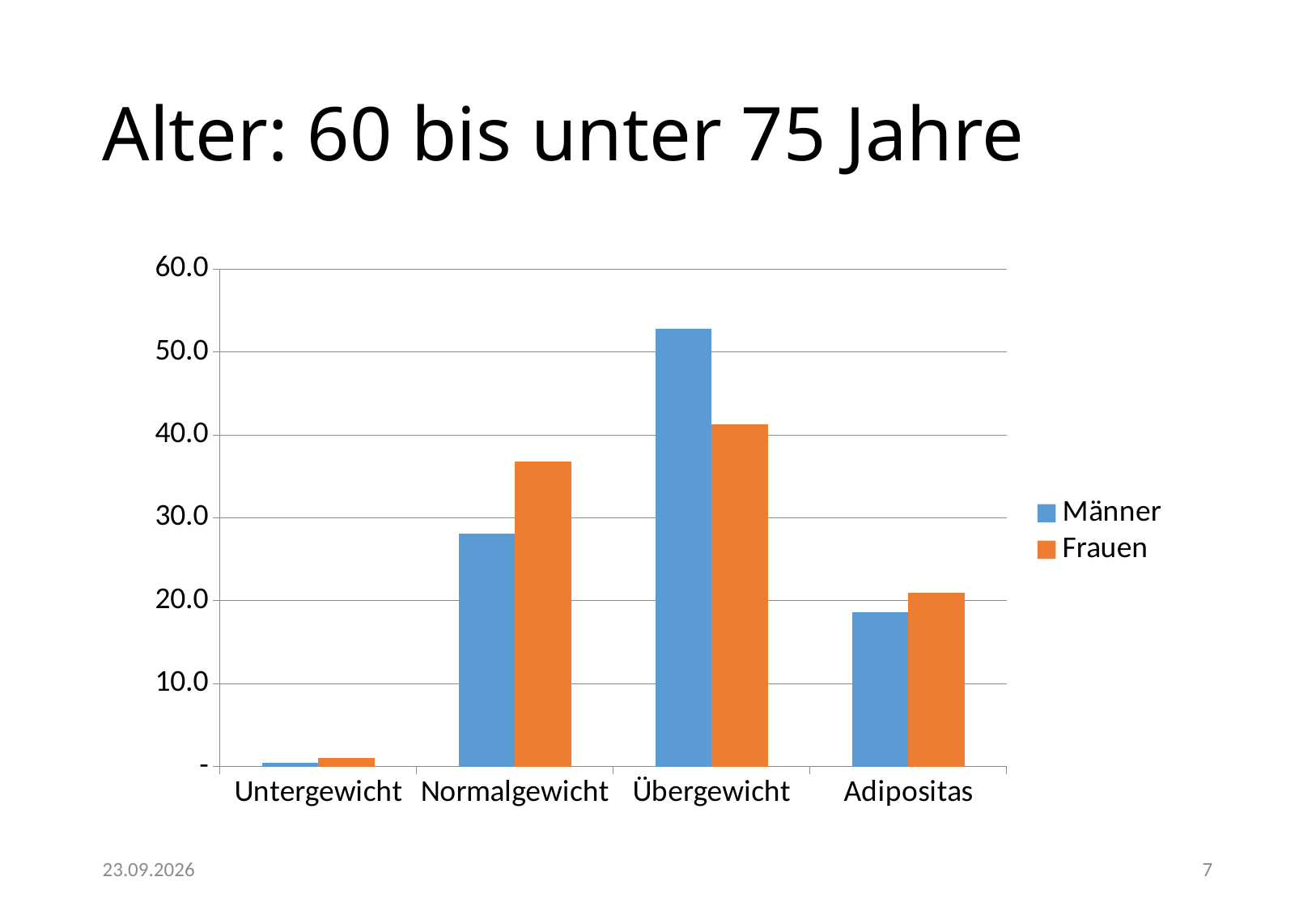
Which category has the highest value for Männer? Übergewicht What kind of chart is shown on the slide? bar chart Is the value for Männer in Übergewicht greater or less than 50.0? greater For Übergewicht, which series has the larger value, Männer or Frauen? Männer How many series does the legend list? 2 Is the value for Männer in Adipositas greater or less than 20.0? less For Normalgewicht, which series has the larger value, Männer or Frauen? Frauen How many categories are shown on the x axis of the chart? 4 What is the title of the slide containing the chart? Alter: 60 bis unter 75 Jahre Is the value for Frauen in Normalgewicht greater or less than 30.0? greater Which category has the lowest value for Männer? Untergewicht Which category has the highest value for Frauen? Übergewicht